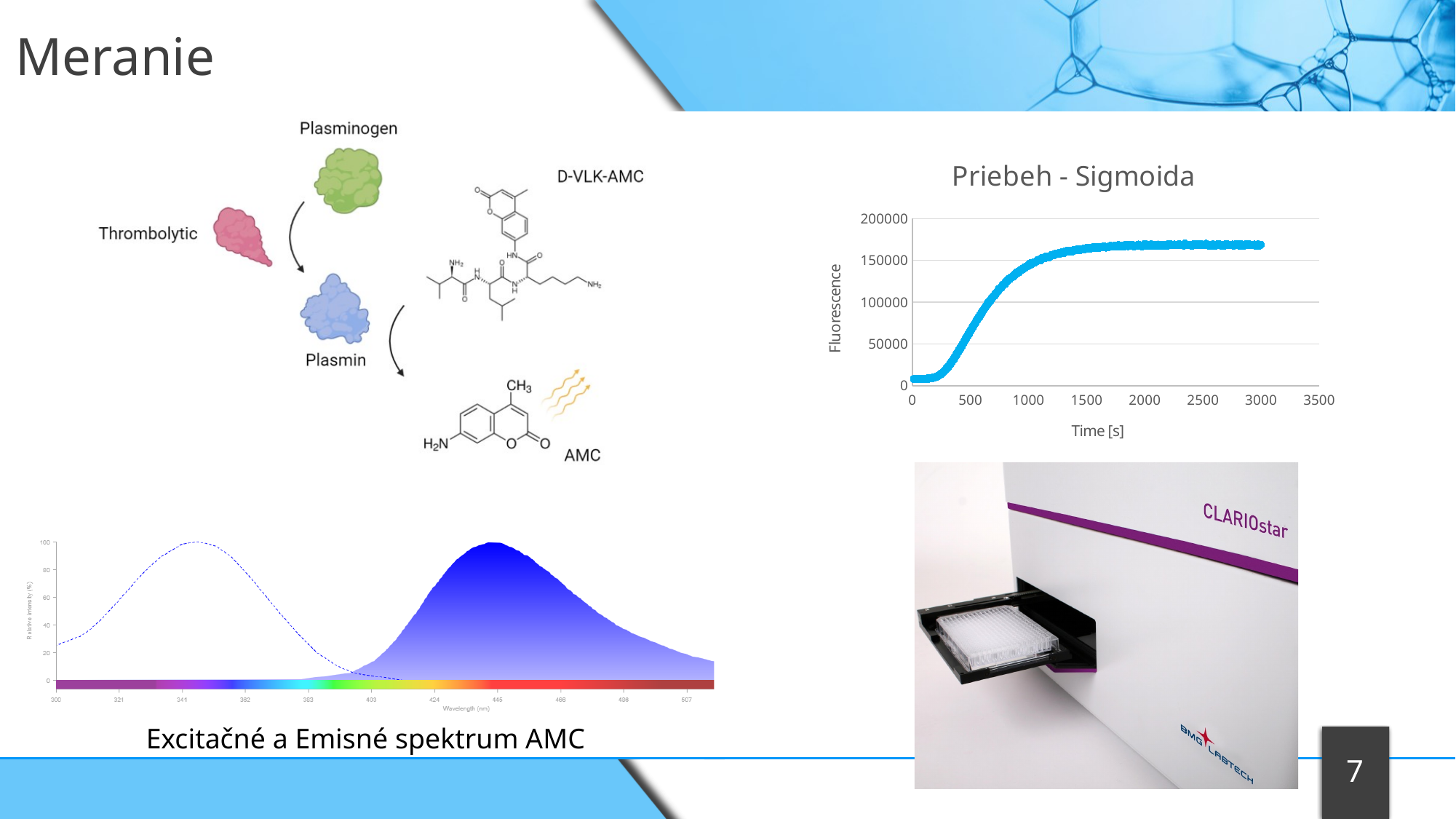
In the chart titled 'Priebeh - Sigmoida', what kind of chart is shown? scatter chart In the chart titled 'Priebeh - Sigmoida', what is the label of the x axis? Time [s] In the chart titled 'Priebeh - Sigmoida', is the highest fluorescence value greater or less than 200000? less In the chart titled 'Priebeh - Sigmoida', is the fluorescence at 2000 s greater or less than 100000? greater In the chart titled 'Priebeh - Sigmoida', which is larger: the fluorescence at 250 s or at 1500 s? 1500 s In the chart titled 'Priebeh - Sigmoida', is the fluorescence at 3000 s greater or less than 150000? greater What is the title of the scatter chart on the right side of the slide? Priebeh - Sigmoida In the chart titled 'Priebeh - Sigmoida', what is the largest value shown on the y axis? 200000 In the chart titled 'Priebeh - Sigmoida', does the fluorescence rise or fall as time increases? rise In the chart titled 'Priebeh - Sigmoida', what is the largest value shown on the x axis? 3500